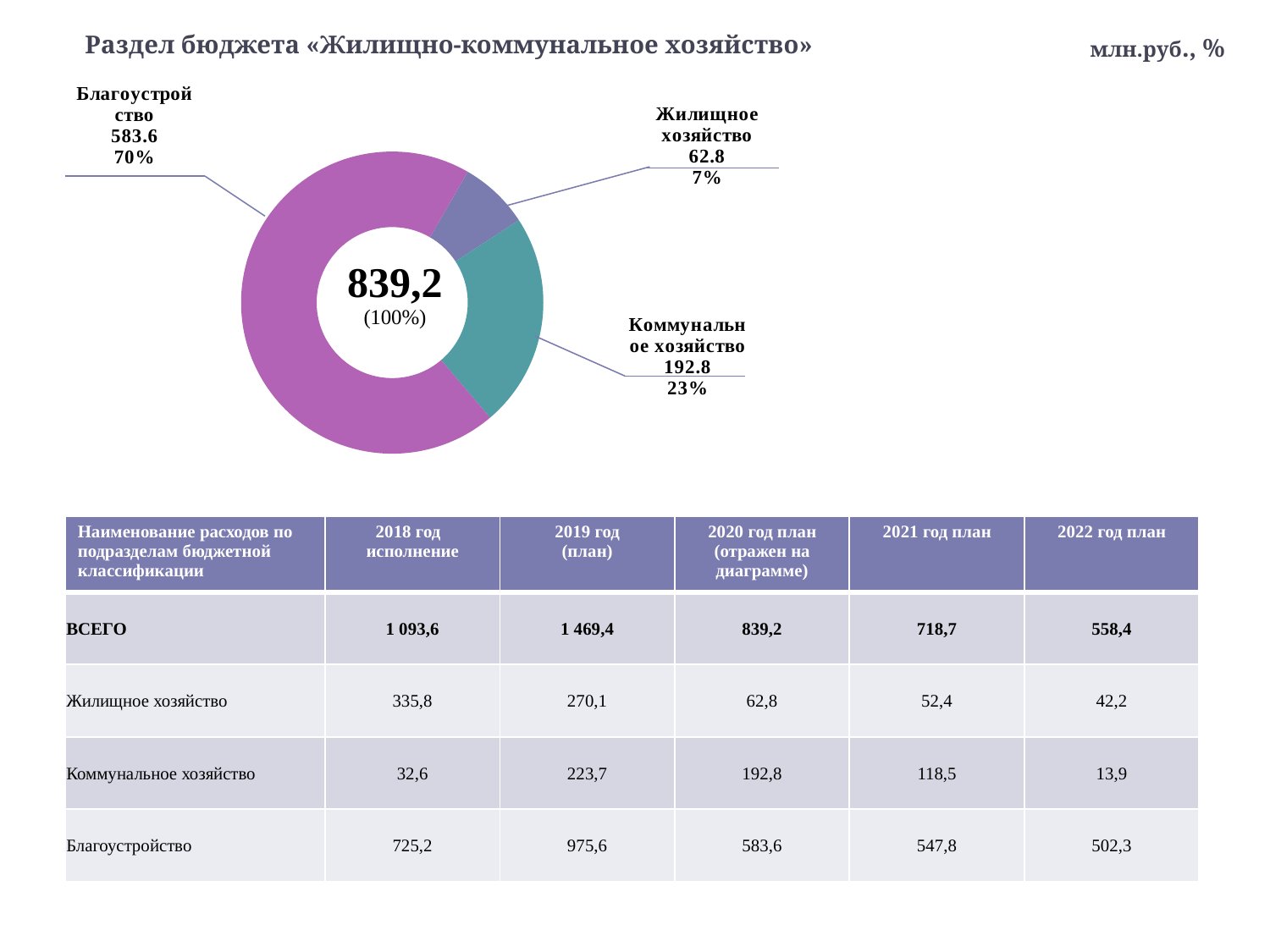
What kind of chart is shown on the slide? Donut (pie) chart What share of the donut chart does Благоустройство take? 70% Which category has the largest slice in the donut chart? Благоустройство What value is shown for Жилищное хозяйство on the donut chart? 62.8 How many slices does the donut chart have? 3 What share of the donut chart does Коммунальное хозяйство take? 23% What value is shown for Благоустройство on the donut chart? 583.6 Which category has the smallest slice in the donut chart? Жилищное хозяйство What share of the donut chart does Жилищное хозяйство take? 7% What value is shown for Коммунальное хозяйство on the donut chart? 192.8 What total value is shown in the centre of the donut chart? 839,2 Which is larger on the donut chart: Коммунальное хозяйство or Жилищное хозяйство? Коммунальное хозяйство